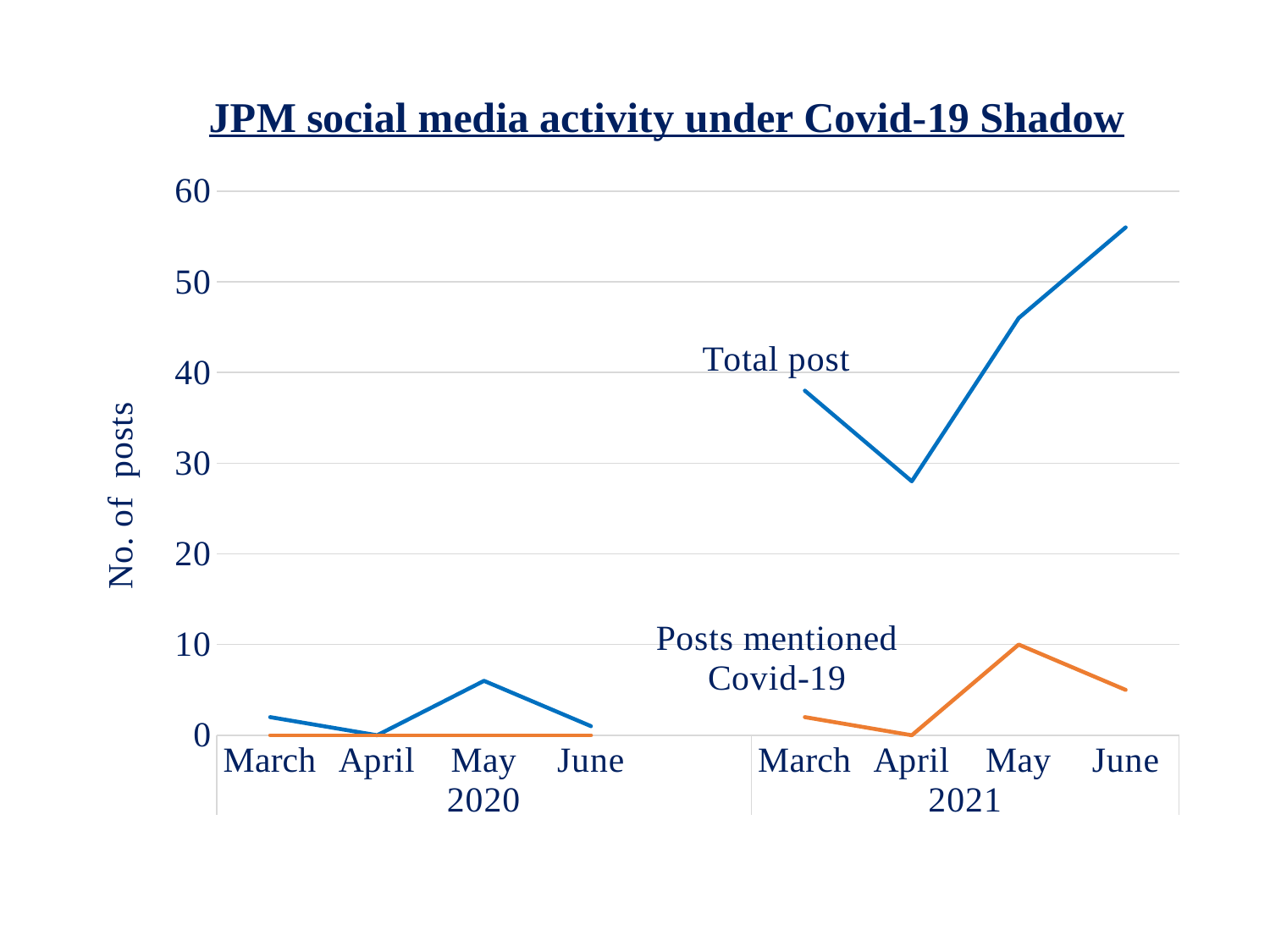
What is the title of the chart? JPM social media activity under Covid-19 Shadow Is the Total post value for June 2021 greater or less than 50? greater What kind of chart is shown on the slide? line chart Is the Total post value for May 2021 greater or less than 40? greater Which series is drawn in orange? Posts mentioned Covid-19 Is the Total post value for April 2021 greater or less than 30? less How many data series are plotted on the chart? 2 In which month is the Total post series at its highest? June 2021 In which month is the Posts mentioned Covid-19 series at its highest? May 2021 How many months (data points) are shown along the x axis? 8 Does the Total post series rise or fall from April 2021 to June 2021? rise Which is larger for Total post: March 2021 or May 2021? May 2021